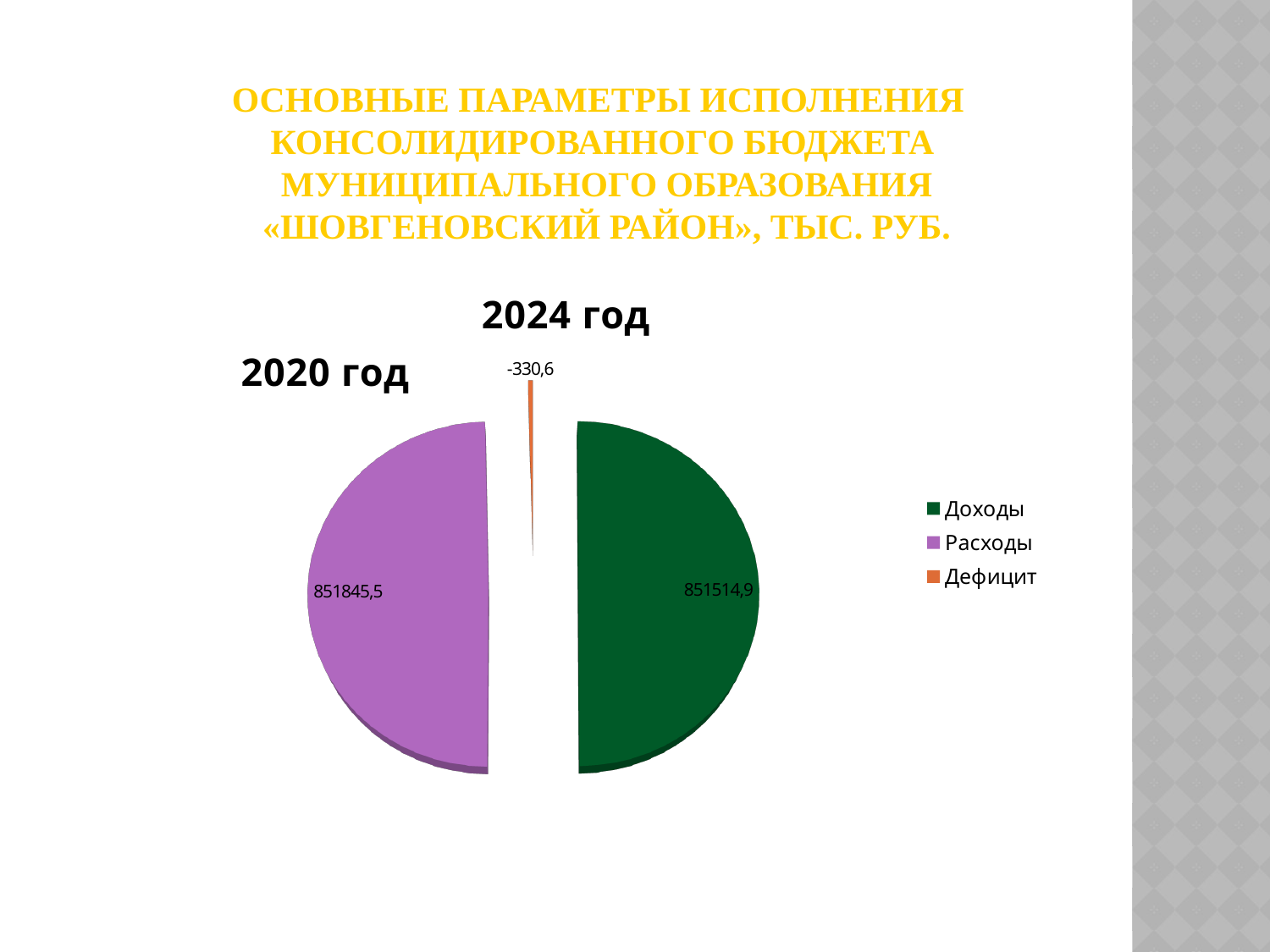
How many entries does the legend list? 3 What kind of chart is shown on the slide? Pie chart What is the title of the chart? 2024 год What is the value shown for Доходы on the pie chart? 851514,9 Which is larger according to the data labels, Доходы or Расходы? Расходы Which category has the smallest value on the pie chart? Дефицит What colour represents Доходы in the chart? Green What is the difference between the Расходы value and the Доходы value? 330,6 What is the value shown for Расходы on the pie chart? 851845,5 What is the value shown for Дефицит on the pie chart? -330,6 How many slices does the pie chart have? 3